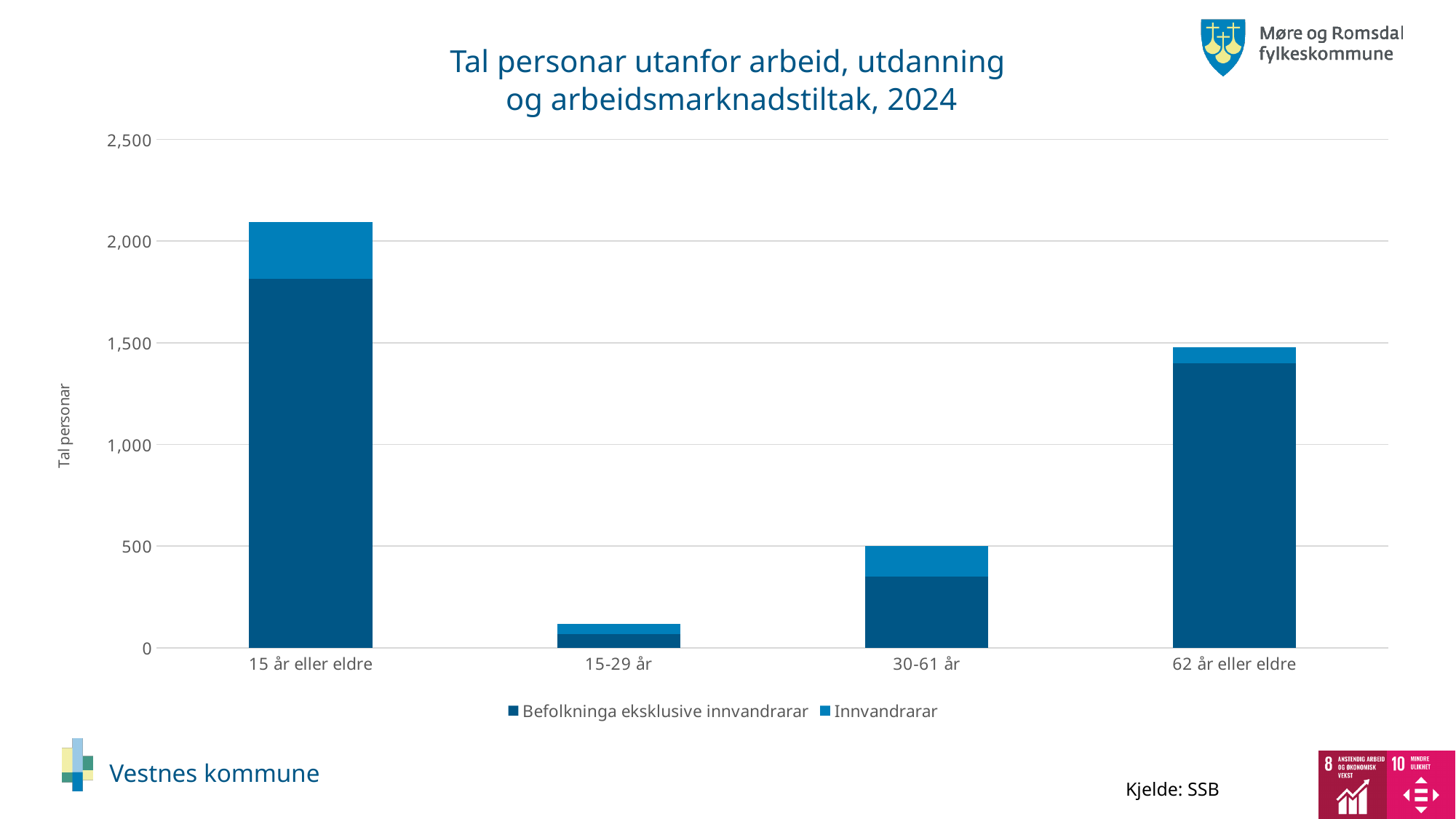
Is the total stacked value for 62 år eller eldre greater or less than 1,000? greater Is the total stacked value for 15 år eller eldre greater or less than 2,000? greater What is the title of the y axis? Tal personar How many series does the legend list? 2 Which stacked bar is taller: 62 år eller eldre or 30-61 år? 62 år eller eldre Is the value of Befolkninga eksklusive innvandrarar for 15 år eller eldre greater or less than 1,500? greater Which age category has the shortest stacked bar? 15-29 år Which age category has the tallest stacked bar? 15 år eller eldre What is the source cited for the chart data? SSB How many age categories are shown on the x axis? 4 What kind of chart is shown on the slide? Stacked bar chart